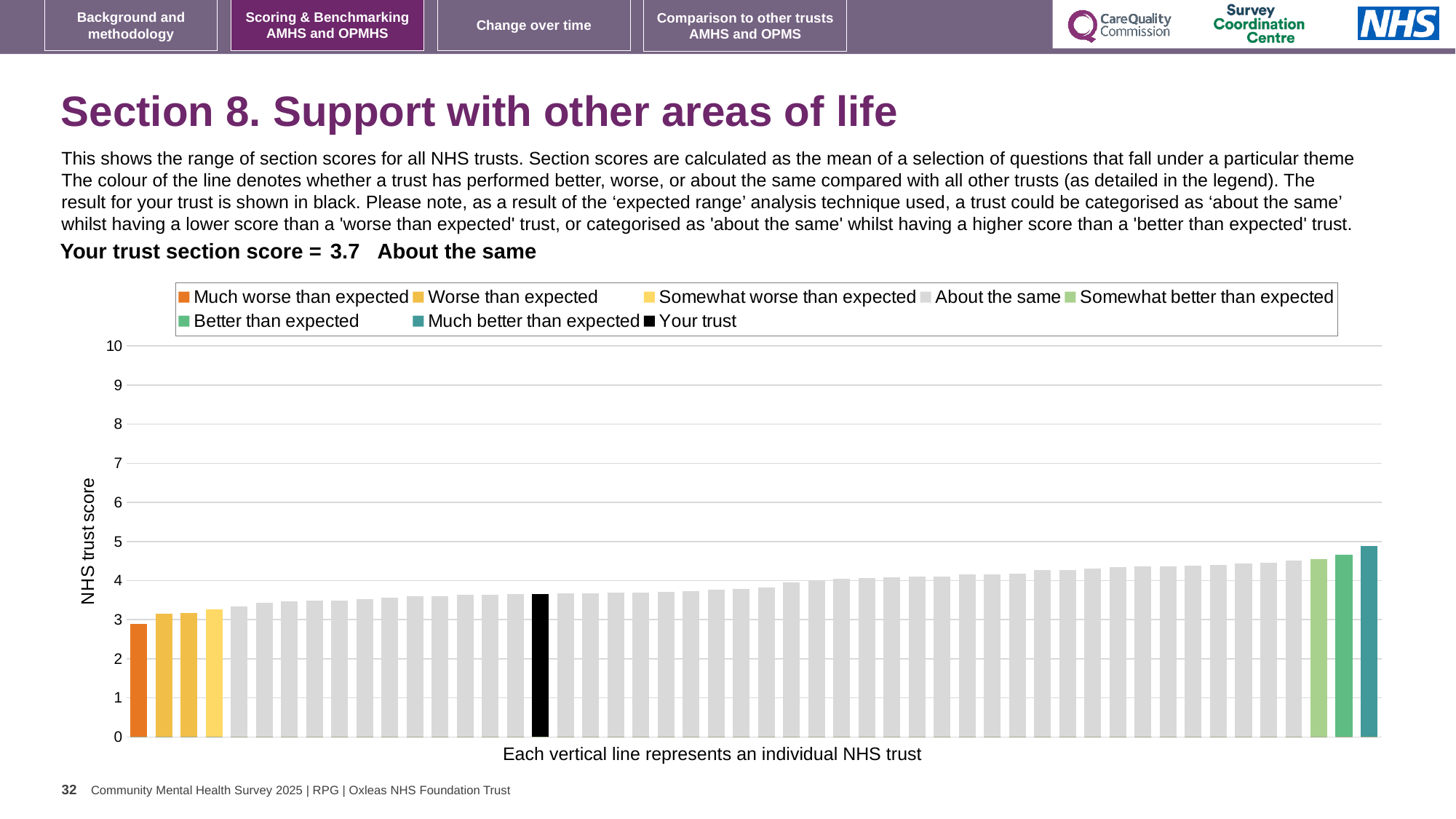
How many entries does the chart legend list? 8 Is the value of the tallest bar (the rightmost, teal bar) greater or less than 5? less What is the section score for your trust (the black bar)? 3.7 Which legend category is represented by the black bar? Your trust Which bar is taller: the leftmost orange bar or the rightmost teal bar? the rightmost teal bar Do the bar values rise or fall moving from left to right along the x axis? rise Is the value of the black 'Your trust' bar greater or less than 4? less Is the value of the shortest bar (the leftmost, orange bar) greater or less than 3? less What kind of chart is shown on the slide? bar chart What is the highest value shown on the y axis? 10 What is the label of the y axis? NHS trust score